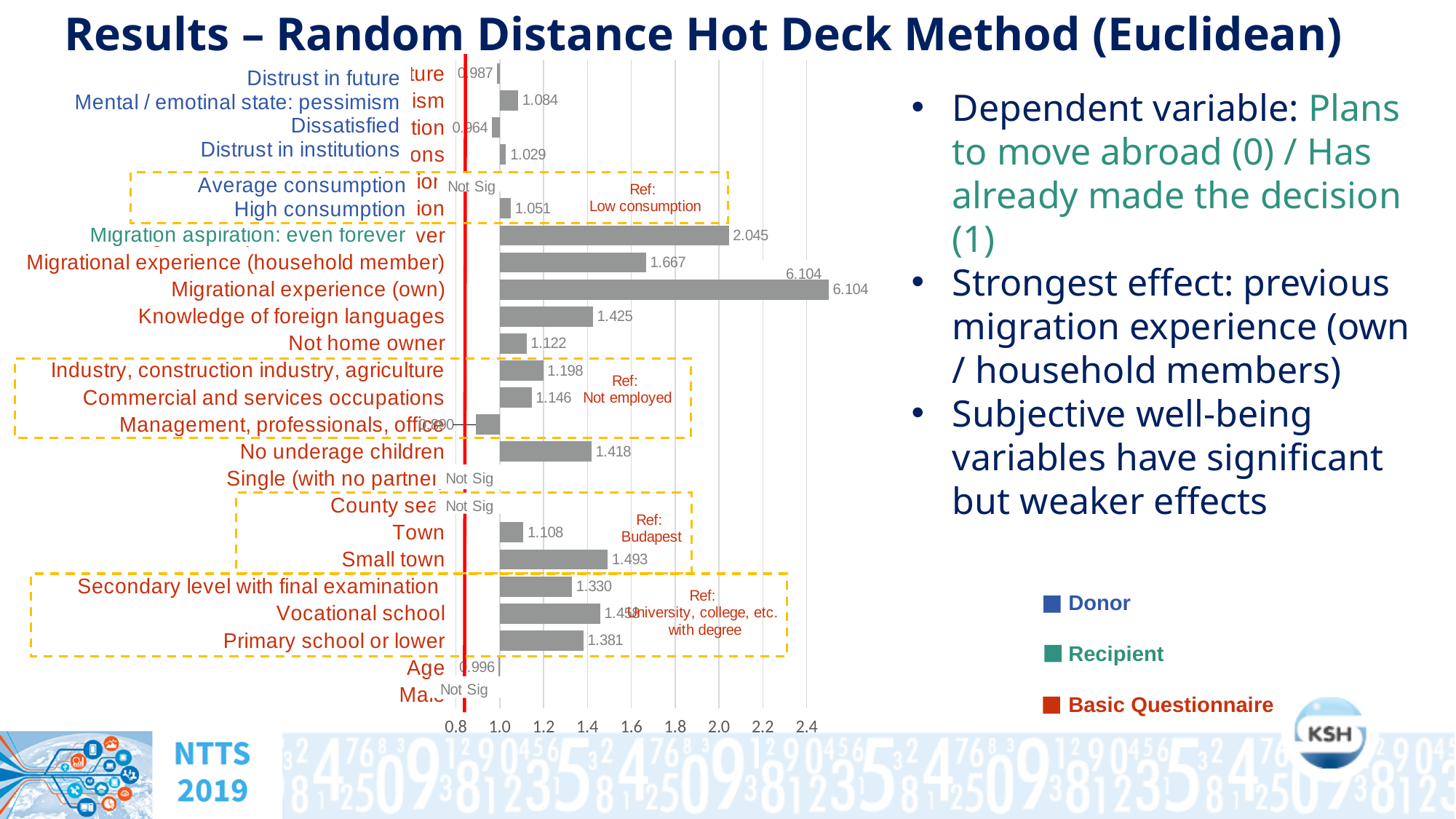
What is the value shown for Small town? 1.493 Which has the larger value, Town or Small town? Small town What is the value shown for Knowledge of foreign languages? 1.425 What is the value shown for Migrational experience (own)? 6.104 What kind of chart is shown on the slide? Bar chart What is the value shown for Age? 0.996 What is the value shown for Not home owner? 1.122 How many entries does the legend list? 3 Which category has the highest value in the chart? Migrational experience (own) What is the reference category for the occupation group (Industry, Commercial, Management)? Not employed What is the difference between the values for Migration aspiration: even forever and Migrational experience (household member)? 0.378 What is the difference between the values for Primary school or lower and Secondary level with final examination? 0.051